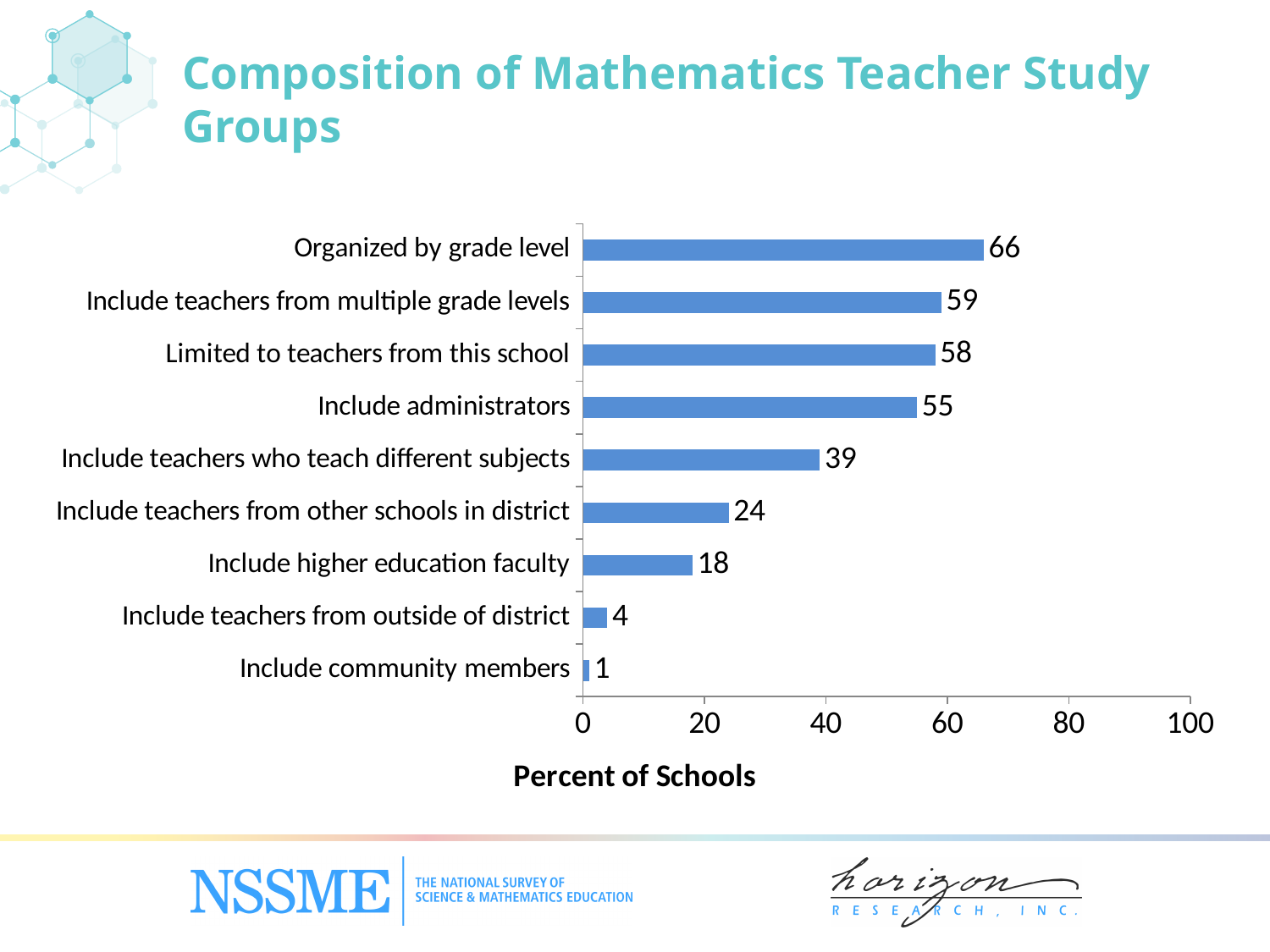
What percent of schools have mathematics teacher study groups organized by grade level? 66 What is the label of the horizontal axis? Percent of Schools What is the value for 'Include teachers from other schools in district'? 24 Which is larger: 'Include administrators' or 'Include teachers who teach different subjects'? Include administrators Which category has the highest percent of schools? Organized by grade level What is the difference between 'Include teachers who teach different subjects' and 'Include teachers from outside of district'? 35 What kind of chart is shown on the slide? Bar chart Is the value for 'Limited to teachers from this school' greater or less than 40? greater What is the value for 'Include higher education faculty'? 18 What is the difference between 'Organized by grade level' and 'Include administrators'? 11 Which category has the lowest percent of schools? Include community members How many categories are shown in the chart? 9